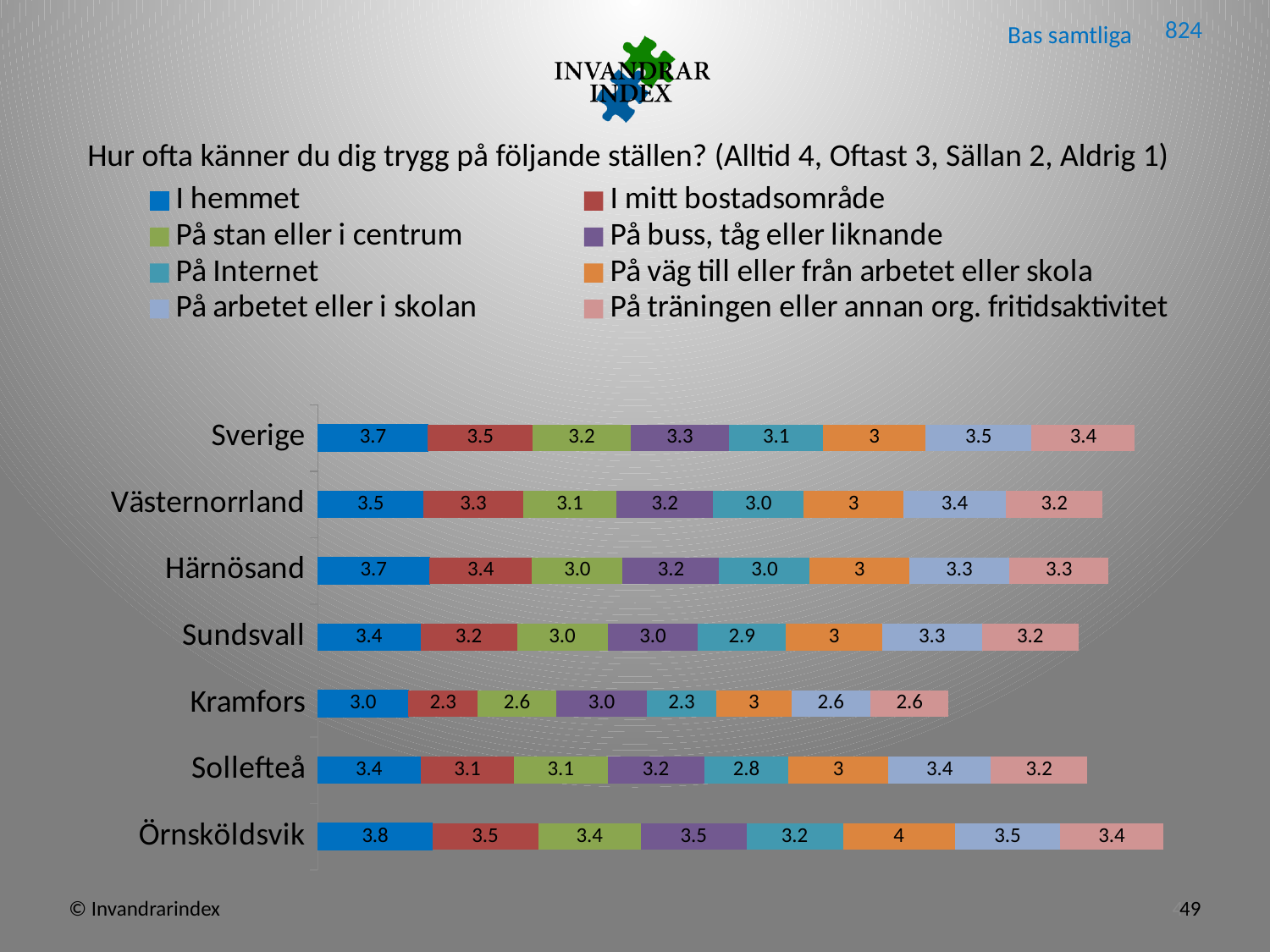
What is the value for 'På väg till eller från arbetet eller skola' for Örnsköldsvik? 4 How many series does the legend list? 8 Which is larger: the 'På stan eller i centrum' value for Örnsköldsvik or for Härnösand? Örnsköldsvik What kind of chart is shown on the slide? Stacked bar chart Which category has the lowest value for 'I hemmet'? Kramfors What is the value for 'I mitt bostadsområde' for Kramfors? 2.3 Which category has the highest value for 'I hemmet'? Örnsköldsvik What is the total of the stacked bar for Kramfors? 21.4 What is the difference between the 'I hemmet' values for Sverige and Kramfors? 0.7 How many categories are shown on the y axis of the chart? 7 What is the value for 'I hemmet' for Örnsköldsvik? 3.8 What is the value for 'På Internet' for Sundsvall? 2.9